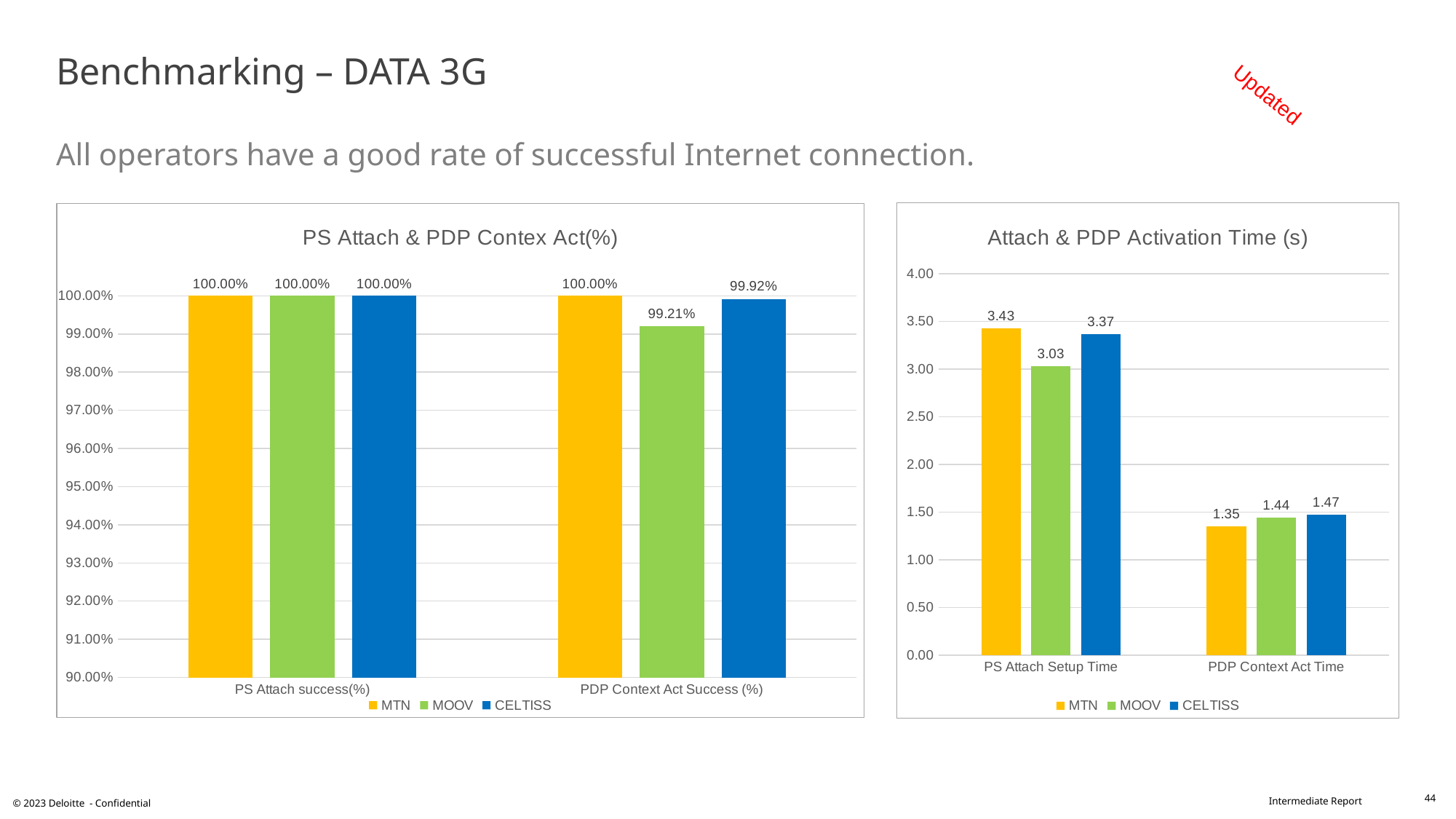
In the 'Attach & PDP Activation Time (s)' chart, what is the difference between MTN and MOOV for PS Attach Setup Time? 0.40 In the 'Attach & PDP Activation Time (s)' chart, which operator has the highest PS Attach Setup Time? MTN In the 'PS Attach & PDP Contex Act(%)' chart, what is the difference between MTN and MOOV for PDP Context Act Success (%)? 0.79% In the 'Attach & PDP Activation Time (s)' chart, which operator has the highest PDP Context Act Time? CELTISS In the 'PS Attach & PDP Contex Act(%)' chart, what is the value for CELTISS in PDP Context Act Success (%)? 99.92% In the 'PS Attach & PDP Contex Act(%)' chart, which operator has the lowest PDP Context Act Success (%)? MOOV What kind of chart is the 'Attach & PDP Activation Time (s)' chart? bar chart In the 'PS Attach & PDP Contex Act(%)' chart, how many series does the legend list? 3 In the 'Attach & PDP Activation Time (s)' chart, what is the PDP Context Act Time for MTN? 1.35 In the 'Attach & PDP Activation Time (s)' chart, what is the PS Attach Setup Time for MOOV? 3.03 In the 'PS Attach & PDP Contex Act(%)' chart, what is the value for MOOV in PDP Context Act Success (%)? 99.21% In the 'Attach & PDP Activation Time (s)' chart, is the PS Attach Setup Time for CELTISS greater or less than 3.00? greater